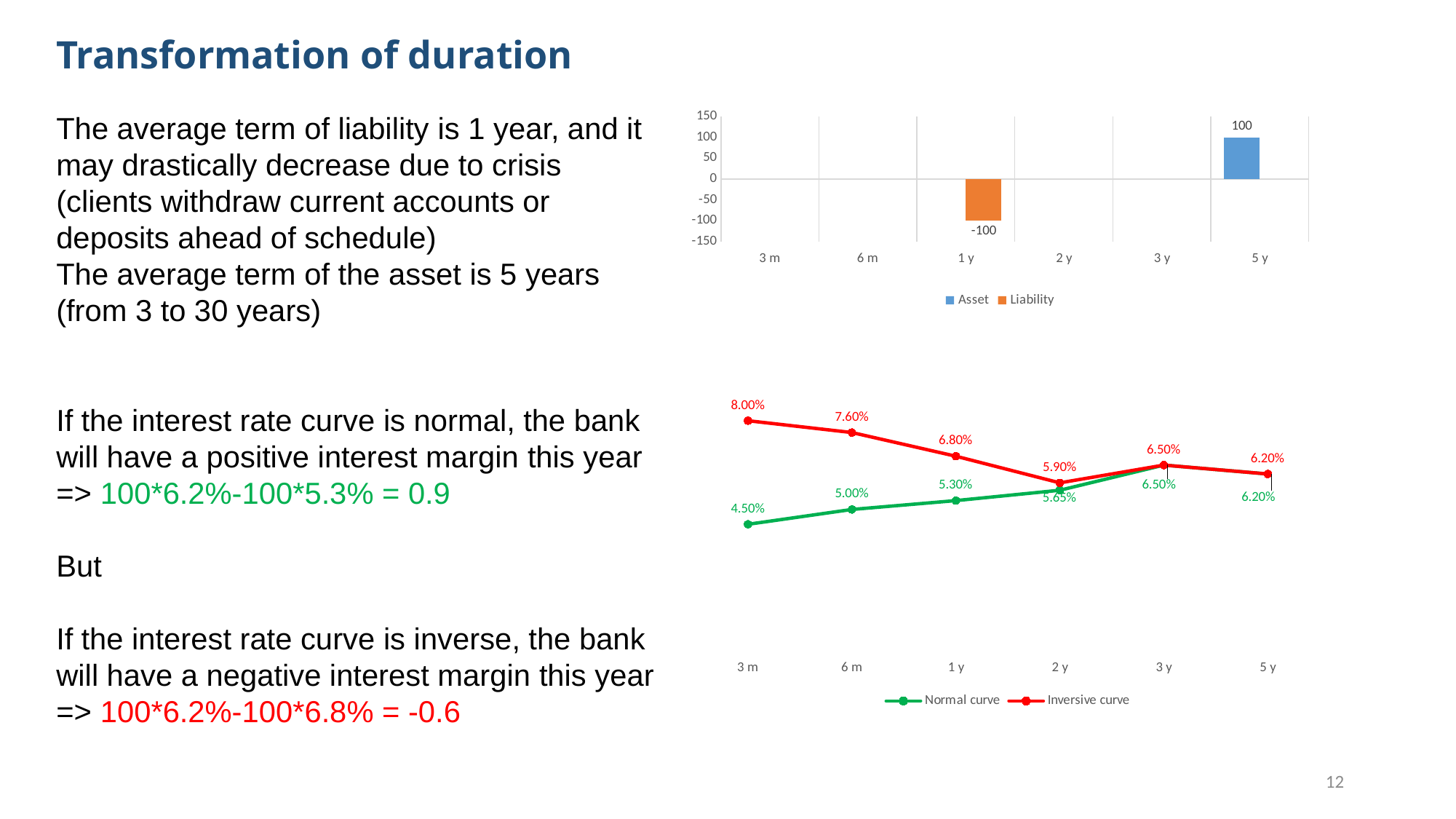
In the top chart, how many series does the legend list? 2 In the top chart, what is the value of the Liability bar at 1 y? -100 In the bottom chart, what is the difference between the Inversive curve and the Normal curve at 1 y? 1.50% In the bottom chart, at which category is the Normal curve highest? 3 y In the bottom chart, does the Inversive curve generally rise or fall from 3 m to 2 y? Fall In the bottom chart, at which category is the Inversive curve lowest? 2 y In the bottom chart, what is the value of the Inversive curve at 3 m? 8.00% In the bottom chart, which is larger at 6 m: the Normal curve or the Inversive curve? Inversive curve In the bottom chart, what is the value of the Normal curve at 2 y? 5.65% In the top chart, how many categories are shown on the x axis? 6 What kind of chart is the top chart? Bar chart In the top chart, what is the value of the Asset bar at 5 y? 100